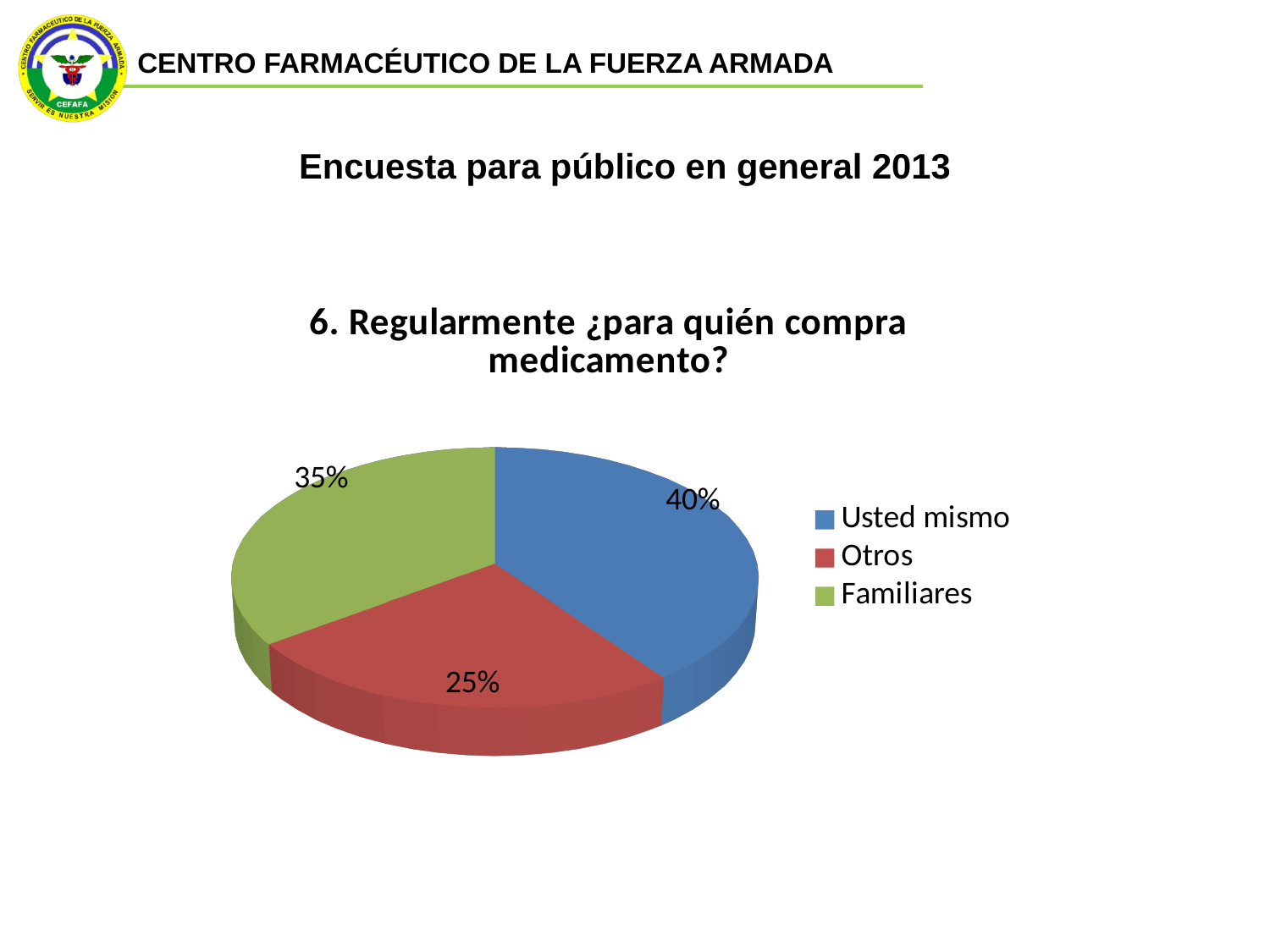
What share of the pie does 'Usted mismo' represent? 40% How many categories does the pie chart have? 3 Which colour represents 'Familiares' in the pie chart? Green What kind of chart is shown on the slide? Pie chart Which category has the largest slice of the pie? Usted mismo Which category has the smallest slice of the pie? Otros What is the difference in percentage points between 'Usted mismo' and 'Familiares'? 5% What is the difference in percentage points between 'Usted mismo' and 'Otros'? 15% What share of the pie does 'Otros' represent? 25% Which is larger, the slice for 'Familiares' or the slice for 'Otros'? Familiares What share of the pie does 'Familiares' represent? 35% What is the title of the chart? 6. Regularmente ¿para quién compra medicamento?